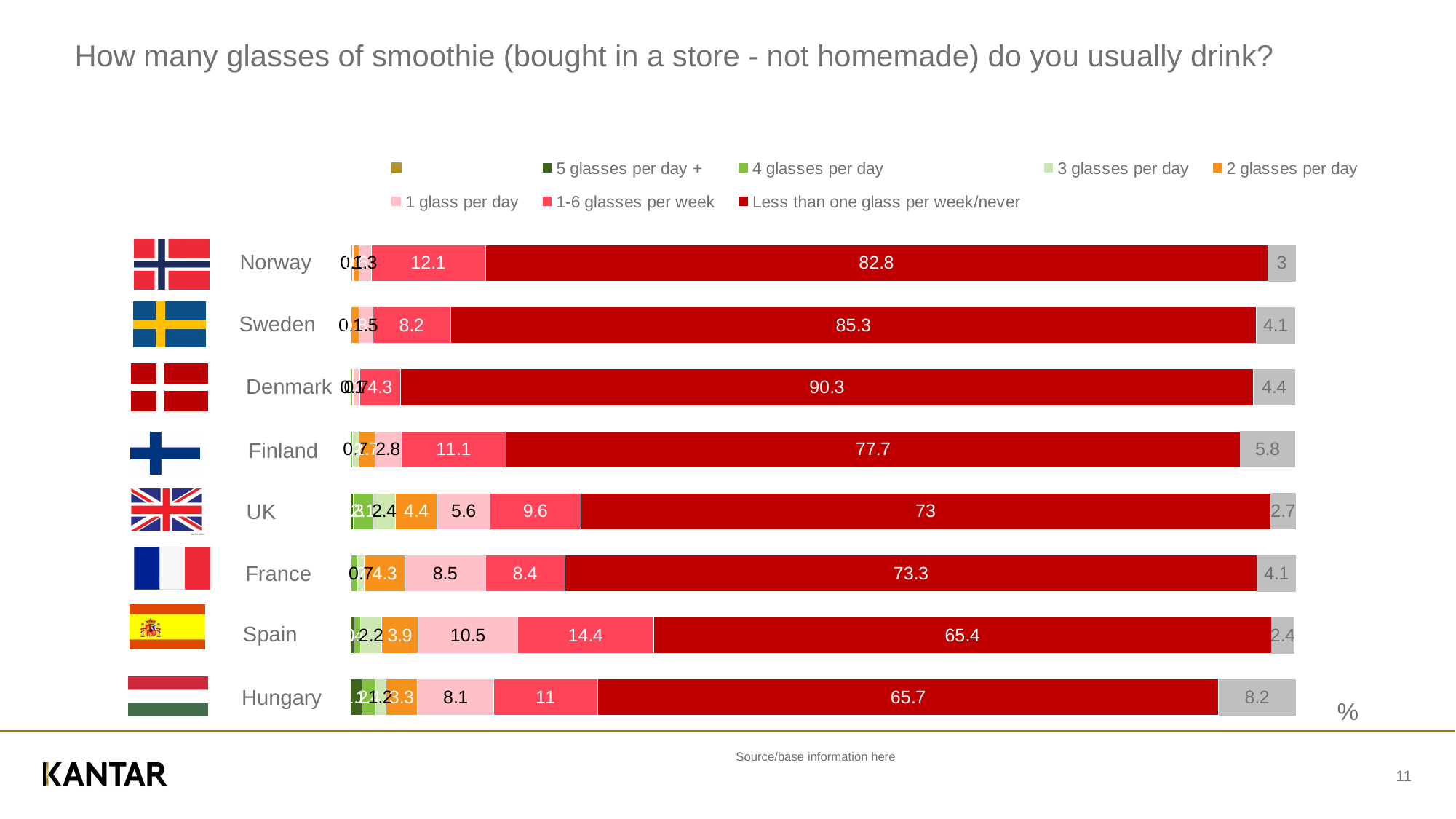
What is the value for 'Less than one glass per week/never' for Denmark? 90.3 What kind of chart is shown on the slide? stacked bar chart What is the value for '1-6 glasses per week' for Spain? 14.4 What is the title of the chart? How many glasses of smoothie (bought in a store - not homemade) do you usually drink? Which country has the highest value for 'Less than one glass per week/never'? Denmark How many countries are shown in the chart? 8 What is the difference between Sweden's and Norway's values for 'Less than one glass per week/never'? 2.5 What is the value for '1 glass per day' for France? 8.5 What is the value for '2 glasses per day' for the UK? 4.4 Which country has the lowest value for 'Less than one glass per week/never'? Spain Which country has the larger value for '1 glass per day', Spain or Hungary? Spain Which country has the larger value for '1-6 glasses per week', Norway or Finland? Norway